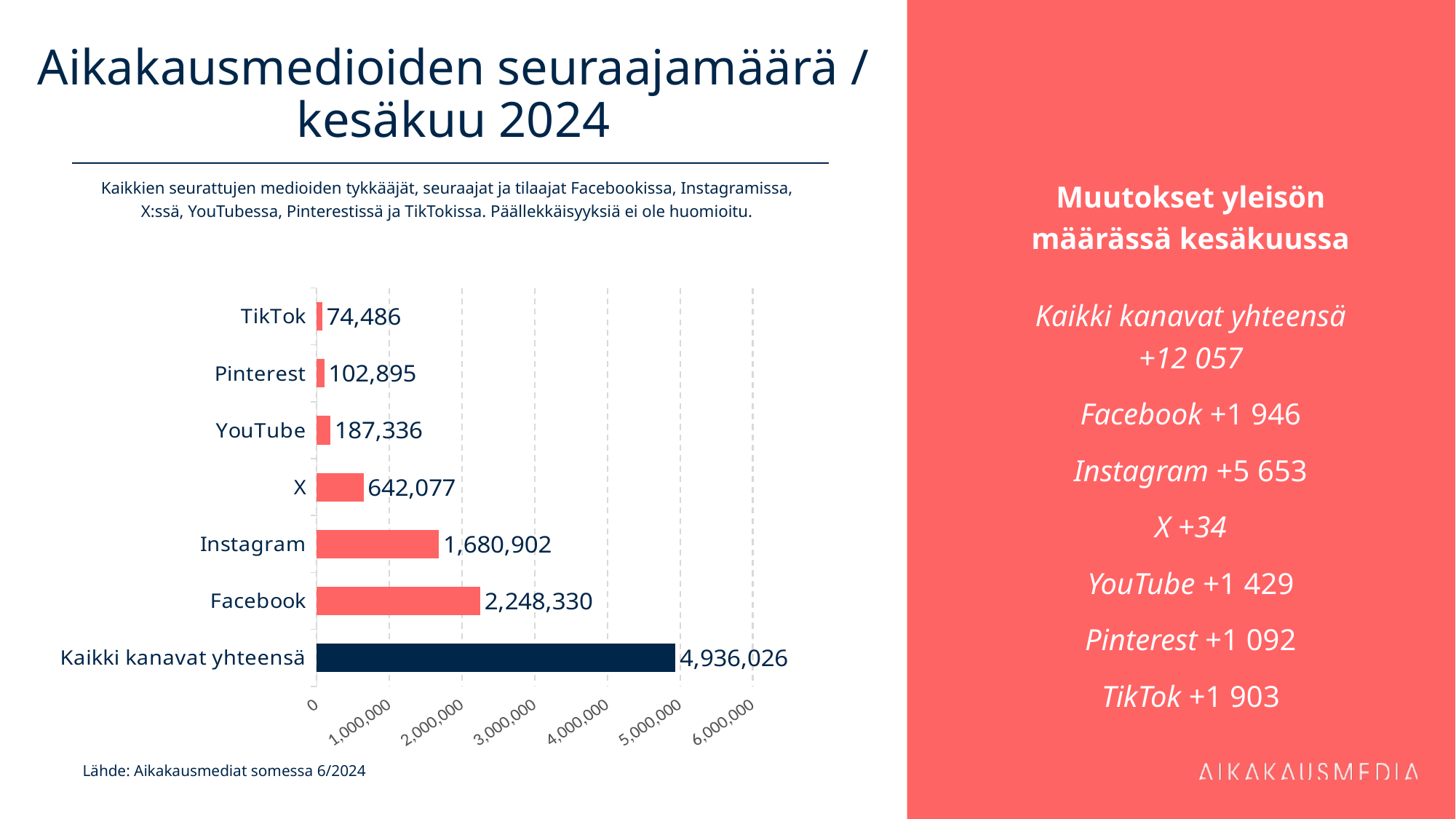
What is the difference between the values for X and YouTube? 454,741 Which category has the lowest value? TikTok What is the value for Kaikki kanavat yhteensä? 4,936,026 How many bars does the chart show? 7 What is the difference between the values for Facebook and Instagram? 567,428 What kind of chart is shown on the slide? bar chart What is the value for Instagram? 1,680,902 What is the value for TikTok? 74,486 Which individual channel (excluding the total bar) has the highest value? Facebook Which is larger, the value for X or the value for YouTube? X What is the value for Facebook? 2,248,330 Is the value for Instagram greater or less than 1,000,000? greater